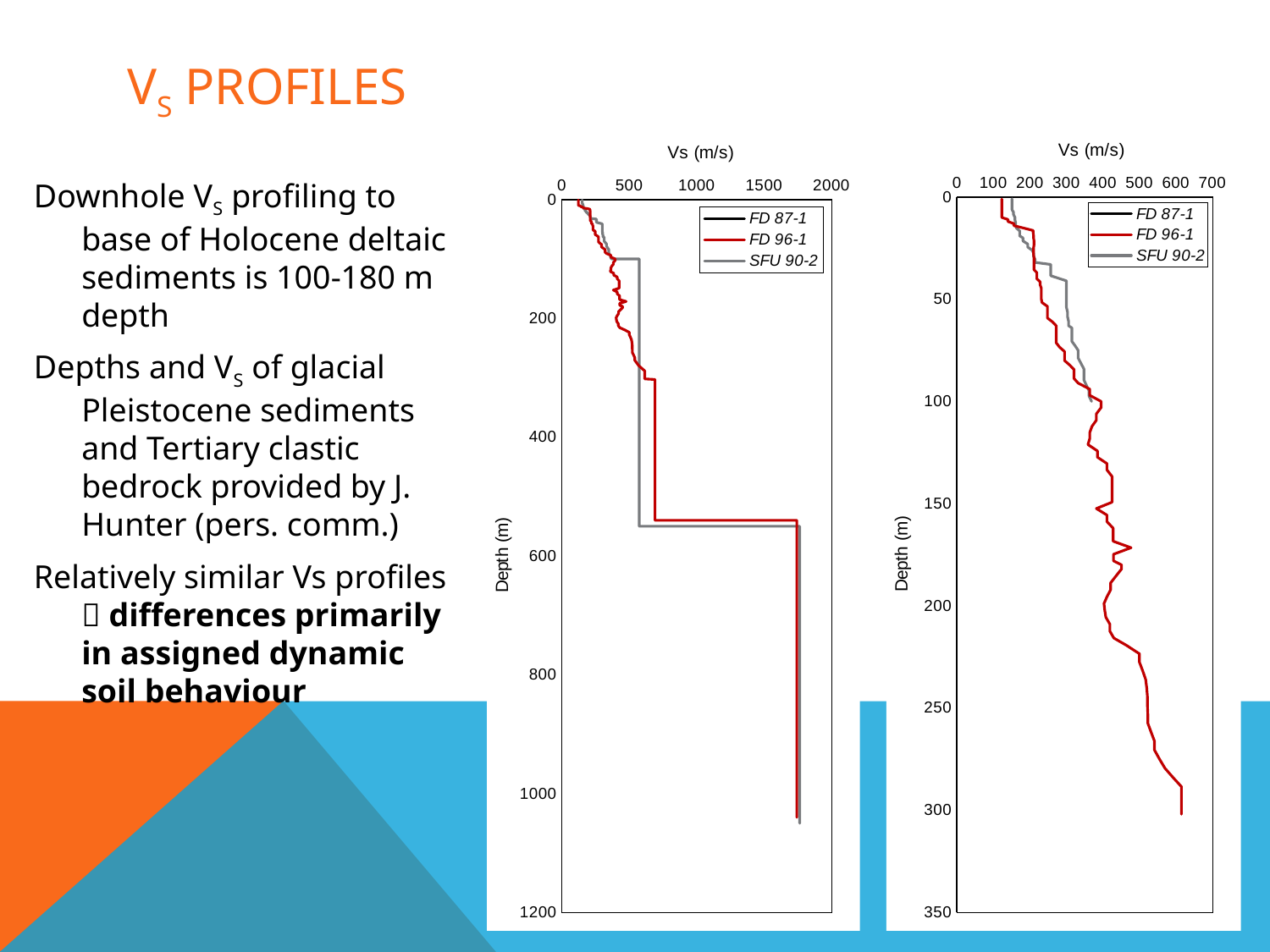
What kind of chart is the left chart on the slide? line chart In the right chart, does the Vs value for FD 96-1 generally increase or decrease as depth increases? increase In the left chart, is the Vs value for SFU 90-2 at a depth of 400 m greater or less than 1000? less In the right chart, is the Vs value for FD 96-1 at a depth of 50 m greater or less than 300? less In the right chart, is the Vs value for FD 96-1 at a depth of 300 m greater or less than 500? greater How many series does the legend of the right chart list? 3 How many series does the legend of the left chart list? 3 In the left chart, which series is drawn in red? FD 96-1 What is the title of the x axis on the right chart? Vs (m/s)